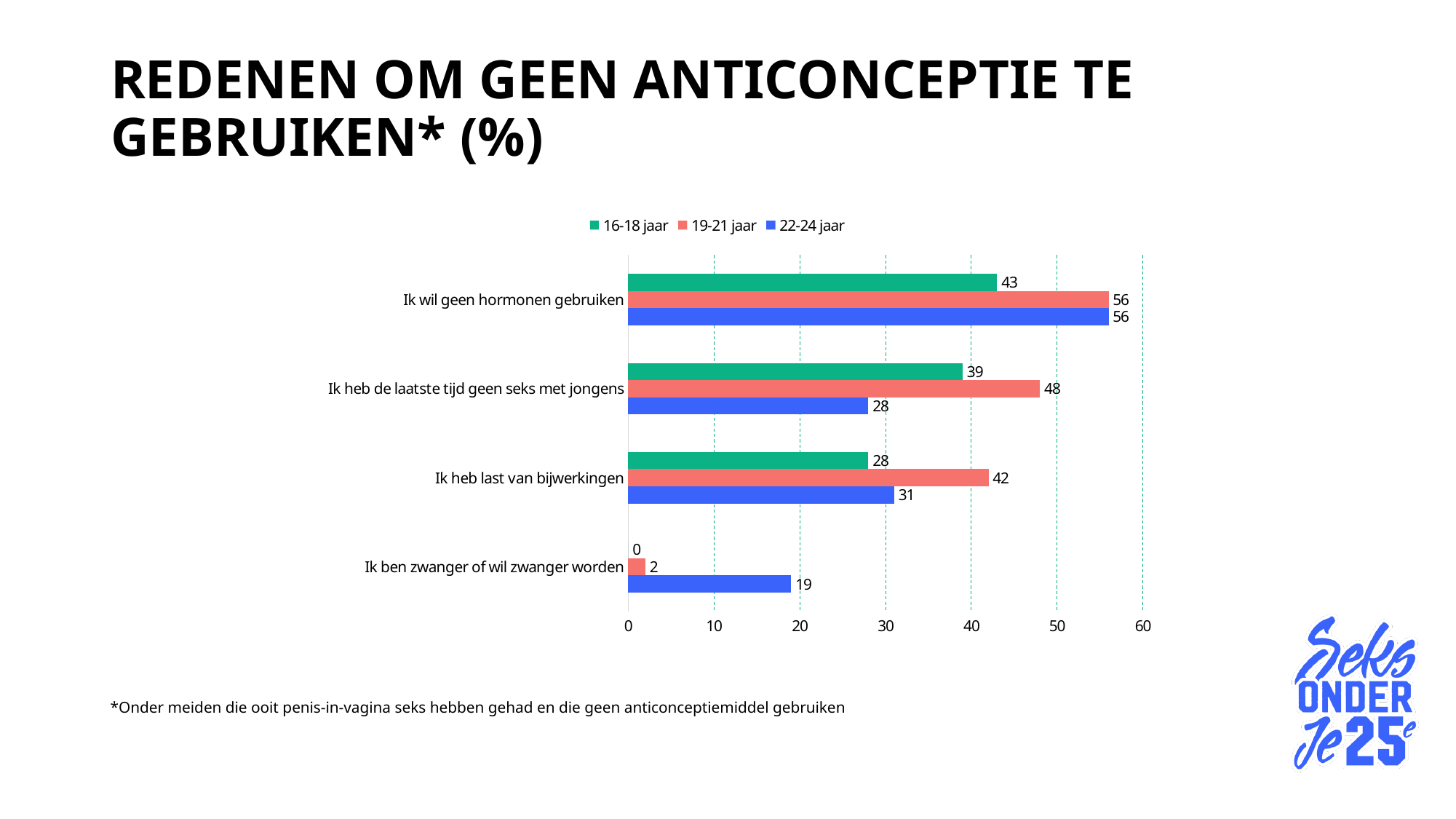
For 'Ik heb last van bijwerkingen', which series has the larger value: '19-21 jaar' or '22-24 jaar'? 19-21 jaar What is the value for '22-24 jaar' in the category 'Ik ben zwanger of wil zwanger worden'? 19 What kind of chart is shown on the slide? bar chart Is the value for '16-18 jaar' in 'Ik heb de laatste tijd geen seks met jongens' greater or less than 30? greater What is the value for '16-18 jaar' in the category 'Ik wil geen hormonen gebruiken'? 43 How many series does the legend list? 3 What is the difference between the '19-21 jaar' and '22-24 jaar' values for 'Ik heb de laatste tijd geen seks met jongens'? 20 Which category has the highest value for the '16-18 jaar' series? Ik wil geen hormonen gebruiken What is the value for '19-21 jaar' in the category 'Ik heb de laatste tijd geen seks met jongens'? 48 Which category has the lowest value for the '22-24 jaar' series? Ik ben zwanger of wil zwanger worden Which colour represents the '22-24 jaar' series? blue How many categories are shown on the chart? 4